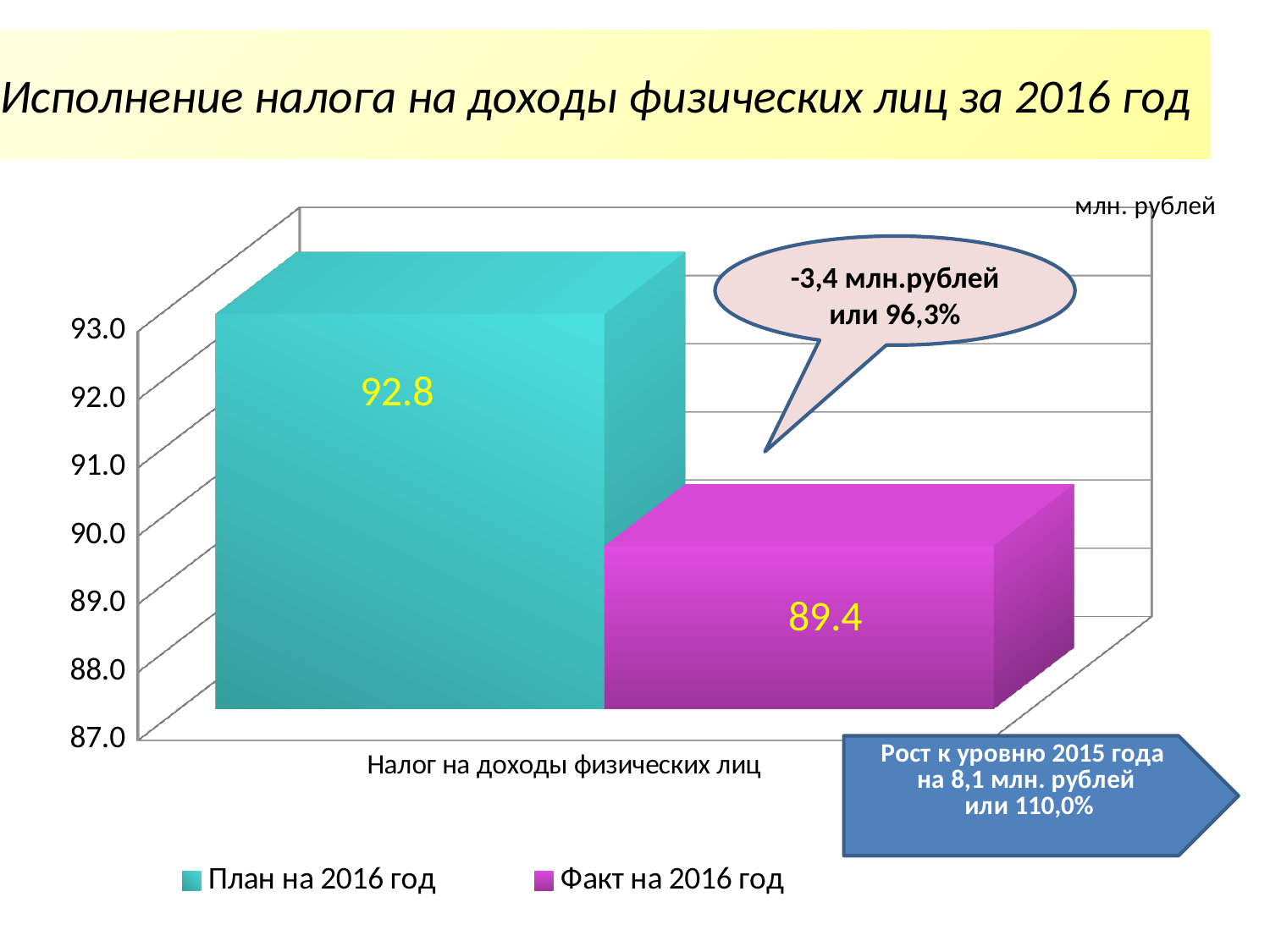
Which series has the higher value, "План на 2016 год" or "Факт на 2016 год"? План на 2016 год How many series does the legend list? 2 What is the value for "Факт на 2016 год"? 89.4 Is the value for "План на 2016 год" greater or less than 92.0? greater How many categories are shown on the x axis? 1 What is the category label on the x axis? Налог на доходы физических лиц What kind of chart is shown on the slide? bar chart Is the value for "Факт на 2016 год" greater or less than 90.0? less Which series has the lowest value? Факт на 2016 год What unit is indicated at the top right of the chart? млн. рублей What is the value for "План на 2016 год"? 92.8 What is the difference between the "План на 2016 год" value and the "Факт на 2016 год" value? 3.4